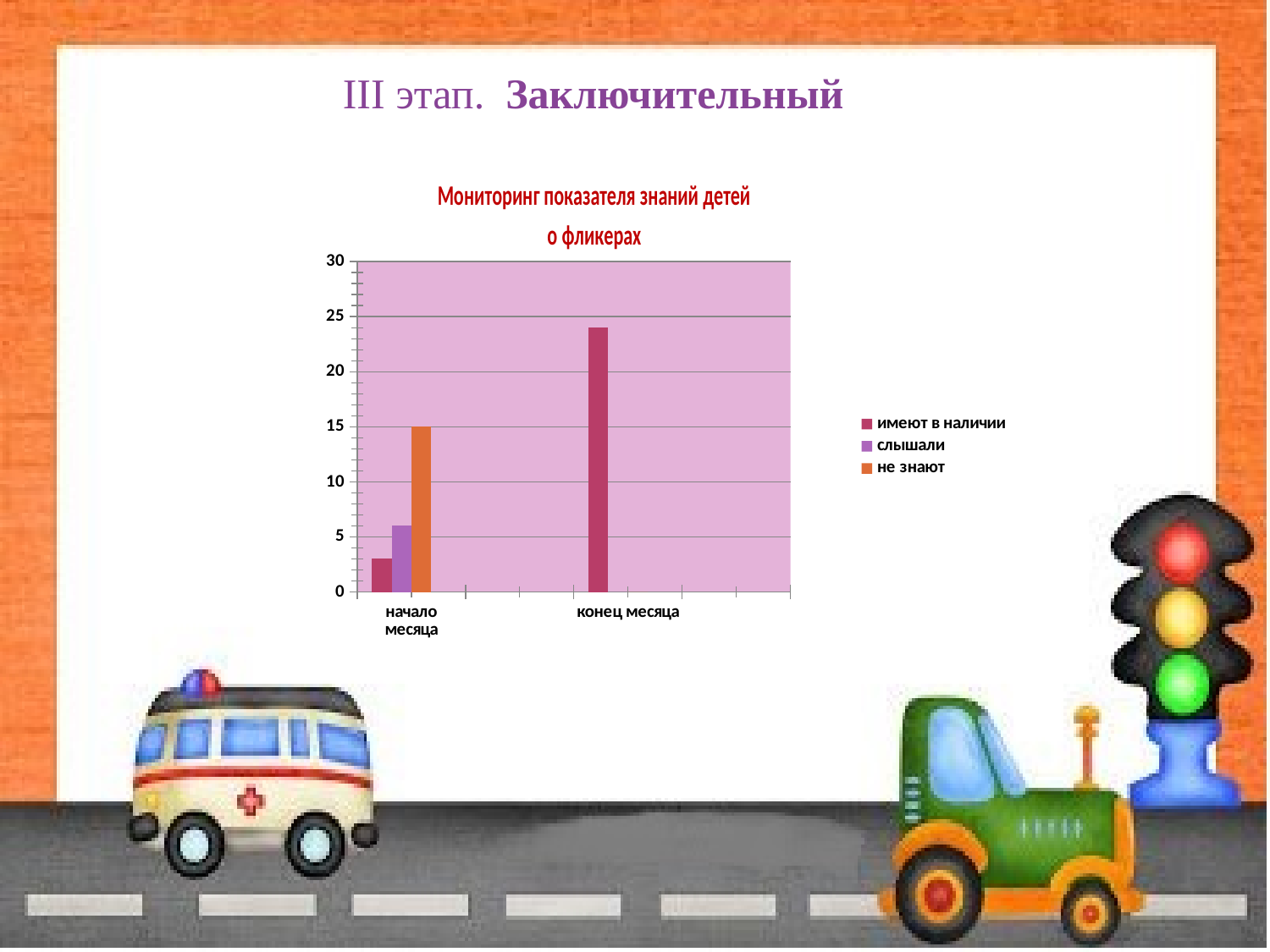
How many categories are shown on the x axis? 2 What is the value for "не знают" at "начало месяца"? 15 Is the value for "имеют в наличии" larger at "начало месяца" or at "конец месяца"? конец месяца Is the value for "слышали" at "начало месяца" greater or less than 5? greater Does the value for "имеют в наличии" rise or fall from "начало месяца" to "конец месяца"? rise Is the value for "имеют в наличии" at "конец месяца" greater or less than 20? greater Which series has the highest value at "начало месяца"? не знают What is the title of the chart? Мониторинг показателя знаний детей о фликерах What kind of chart is shown on the slide? bar chart How many series does the legend list? 3 Is the value for "имеют в наличии" at "начало месяца" greater or less than 5? less Which series has the lowest value at "начало месяца"? имеют в наличии